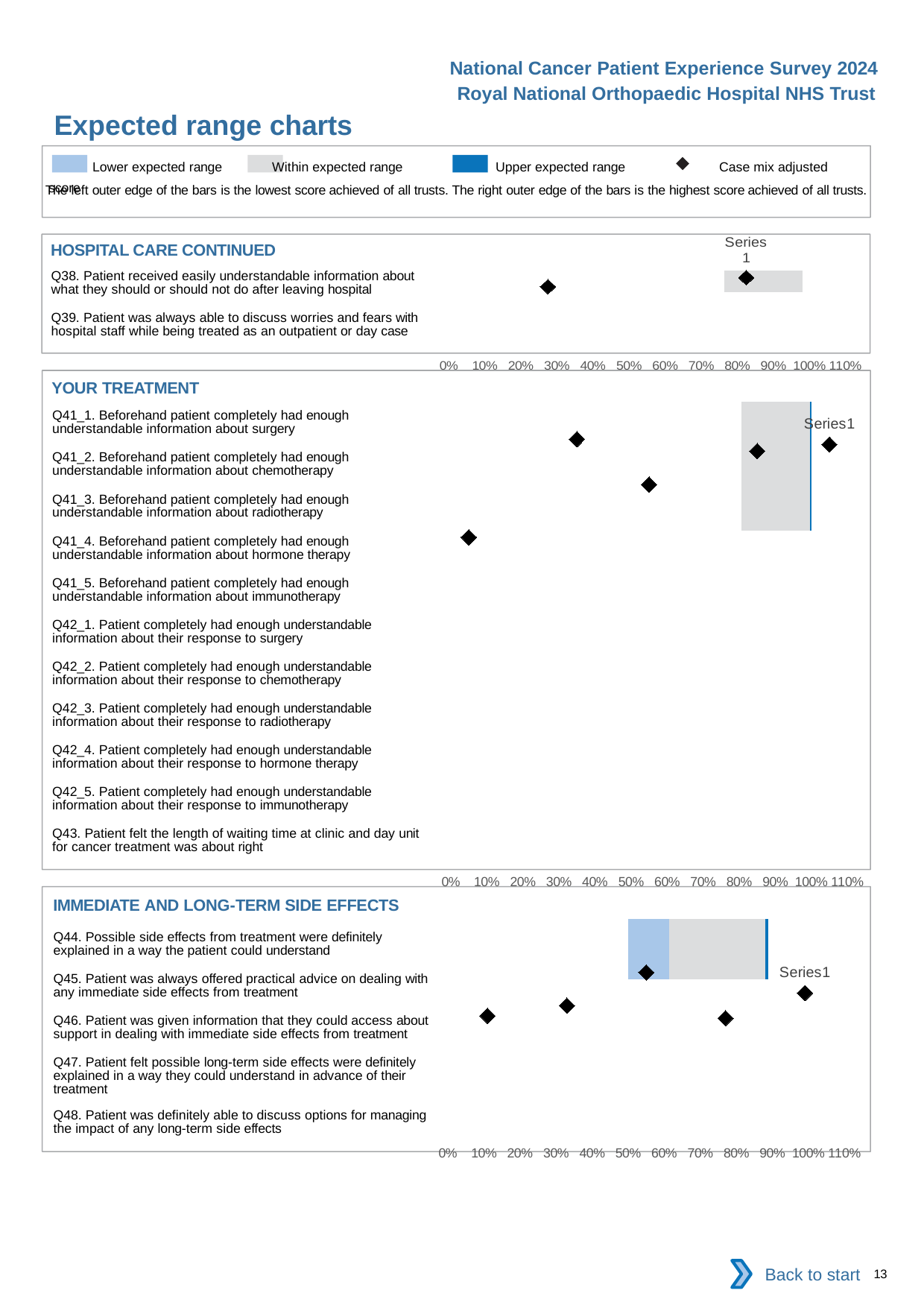
In the YOUR TREATMENT chart, is the leftmost diamond marker greater or less than 20%? less What is the highest tick label shown on the x axis of the charts? 110% How many questions are listed in the YOUR TREATMENT chart section? 11 How many entries does the legend at the top of the slide list? 4 How many questions are listed in the HOSPITAL CARE CONTINUED chart section? 2 Which chart section on the slide lists the most questions? YOUR TREATMENT How many chart sections are shown on the slide? 3 In the IMMEDIATE AND LONG-TERM SIDE EFFECTS chart, is the leftmost diamond marker greater or less than 30%? less What is the title of the slide containing the charts? Expected range charts